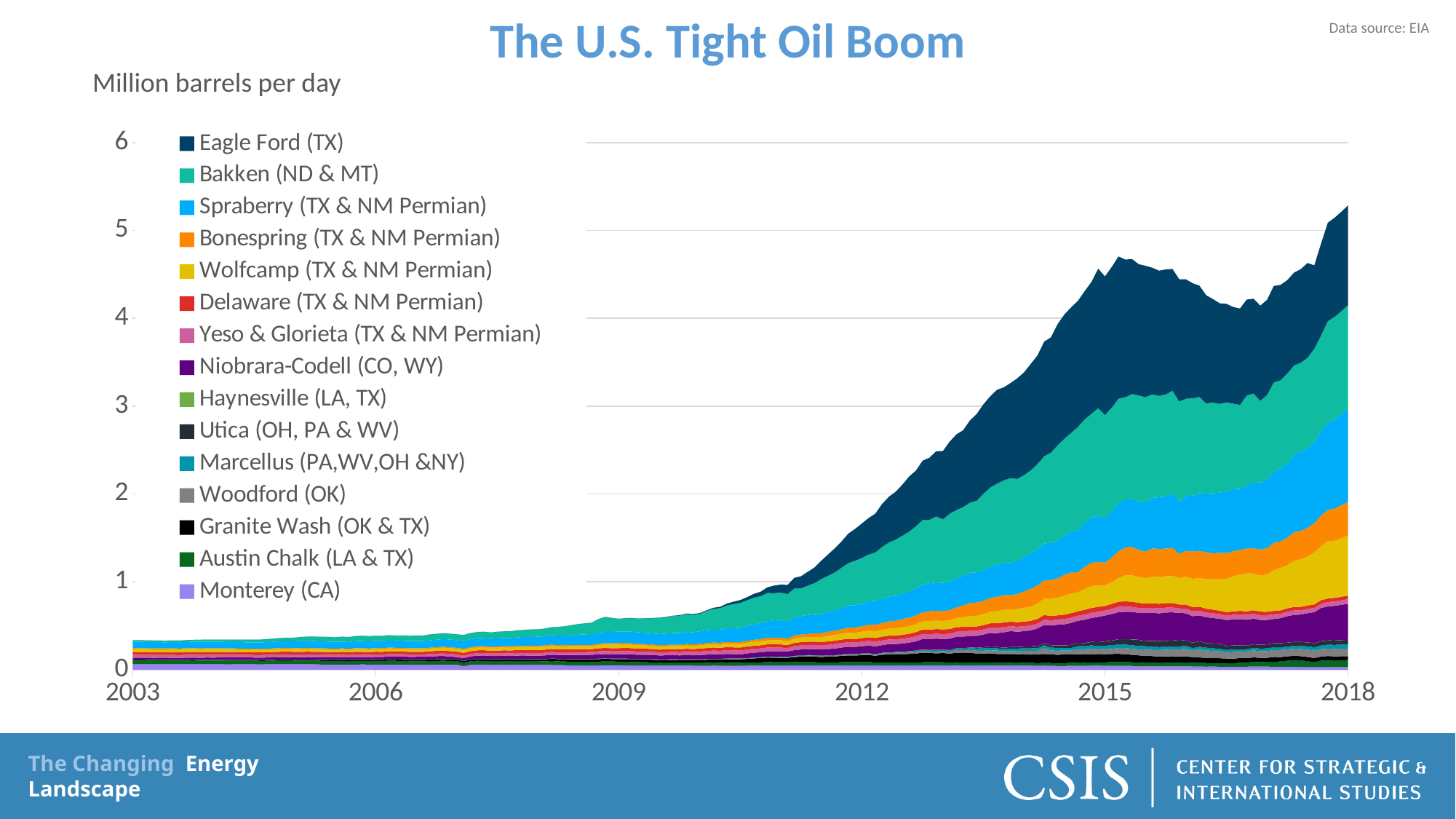
Does total tight oil production rise or fall from 2003 to 2018? Rise Is the total production in 2018 greater or less than 5 million barrels per day? greater What is the title of the chart? The U.S. Tight Oil Boom Is the total production in 2015 greater or less than 4 million barrels per day? greater How many year labels are shown on the x axis? 6 What kind of chart is shown on the slide? Stacked area chart Is the total production in 2003 greater or less than 1 million barrels per day? less How many series does the legend list? 15 What unit is the y axis measured in, according to the label above the chart? Million barrels per day Which is larger, total production in 2018 or total production in 2015? 2018